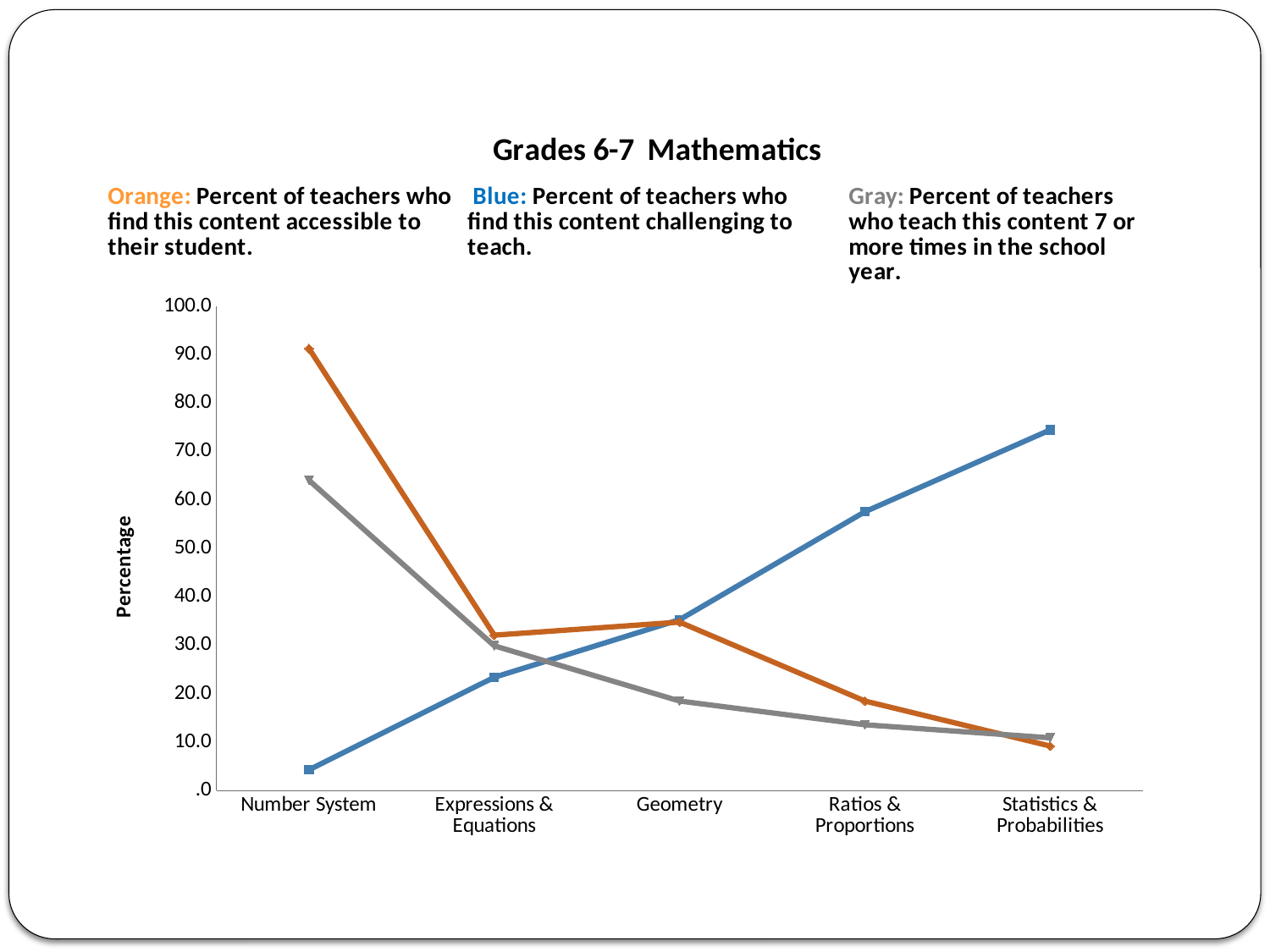
For which category is the blue series (teachers who find the content challenging to teach) highest? Statistics & Probabilities For which category is the orange series (teachers who find the content accessible) highest? Number System At Statistics & Probabilities, which is larger: the blue series or the orange series? blue Is the orange series value for Number System greater or less than 80? greater Is the blue series value for Number System greater or less than 10? less What is the label on the y axis? Percentage Does the blue series rise or fall moving from Number System to Statistics & Probabilities? rise What kind of chart is shown on the slide? line chart For which category is the blue series lowest? Number System How many categories are shown along the x axis? 5 What is the title of the chart? Grades 6-7 Mathematics How many series does the legend describe? 3